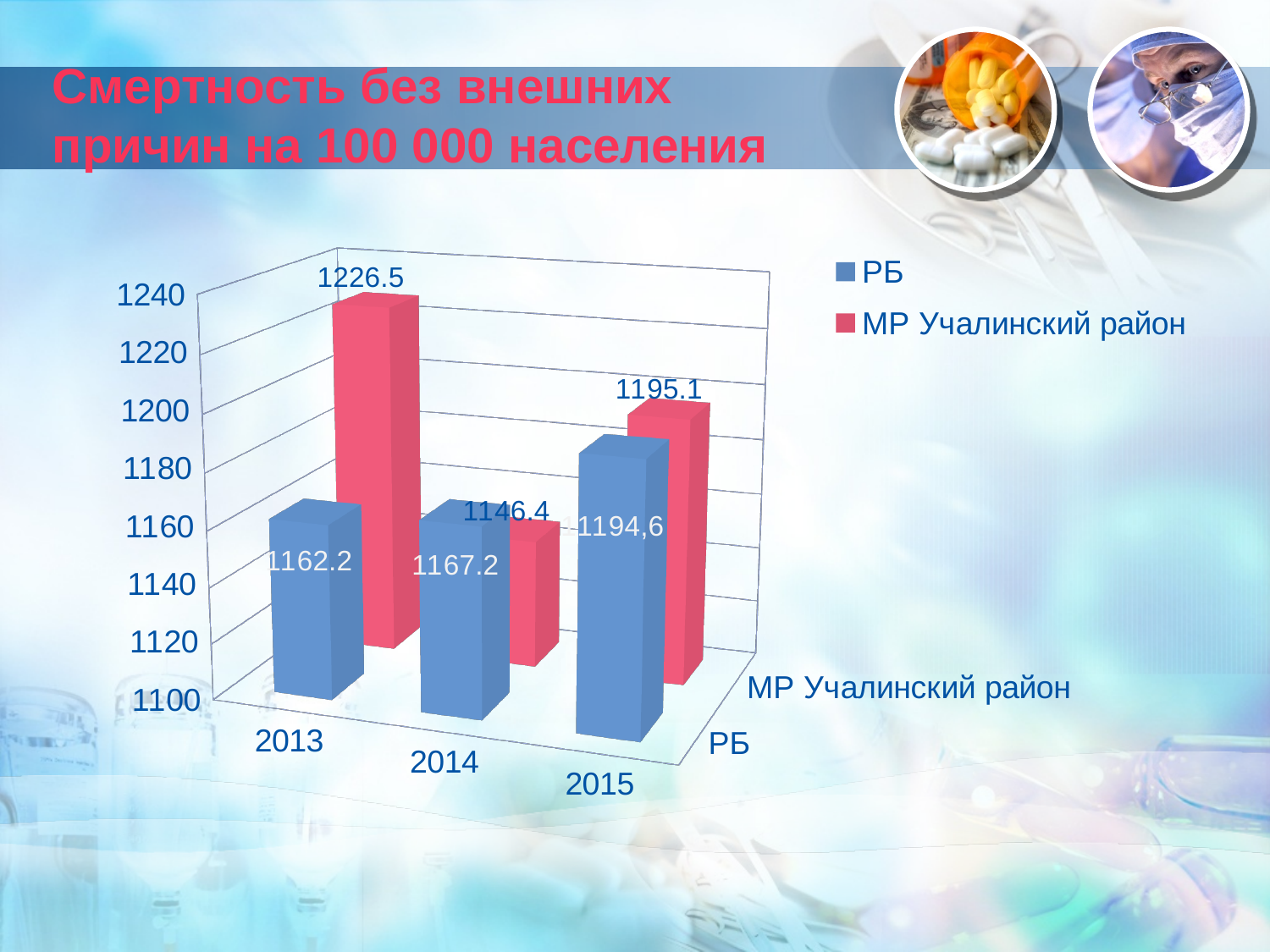
In which year is the value for МР Учалинский район highest? 2013 In which year is the value for МР Учалинский район lowest? 2014 What is the value for РБ in 2015? 1194,6 What is the value for МР Учалинский район in 2014? 1146.4 Which is larger in 2014: РБ or МР Учалинский район? РБ In which year is the value for РБ highest? 2015 Does the value for РБ rise or fall from 2013 to 2015? rise How many years are shown on the x axis? 3 What is the value for МР Учалинский район in 2013? 1226.5 How many series does the legend list? 2 What is the value for РБ in 2013? 1162.2 What is the difference between МР Учалинский район and РБ in 2013? 64.3